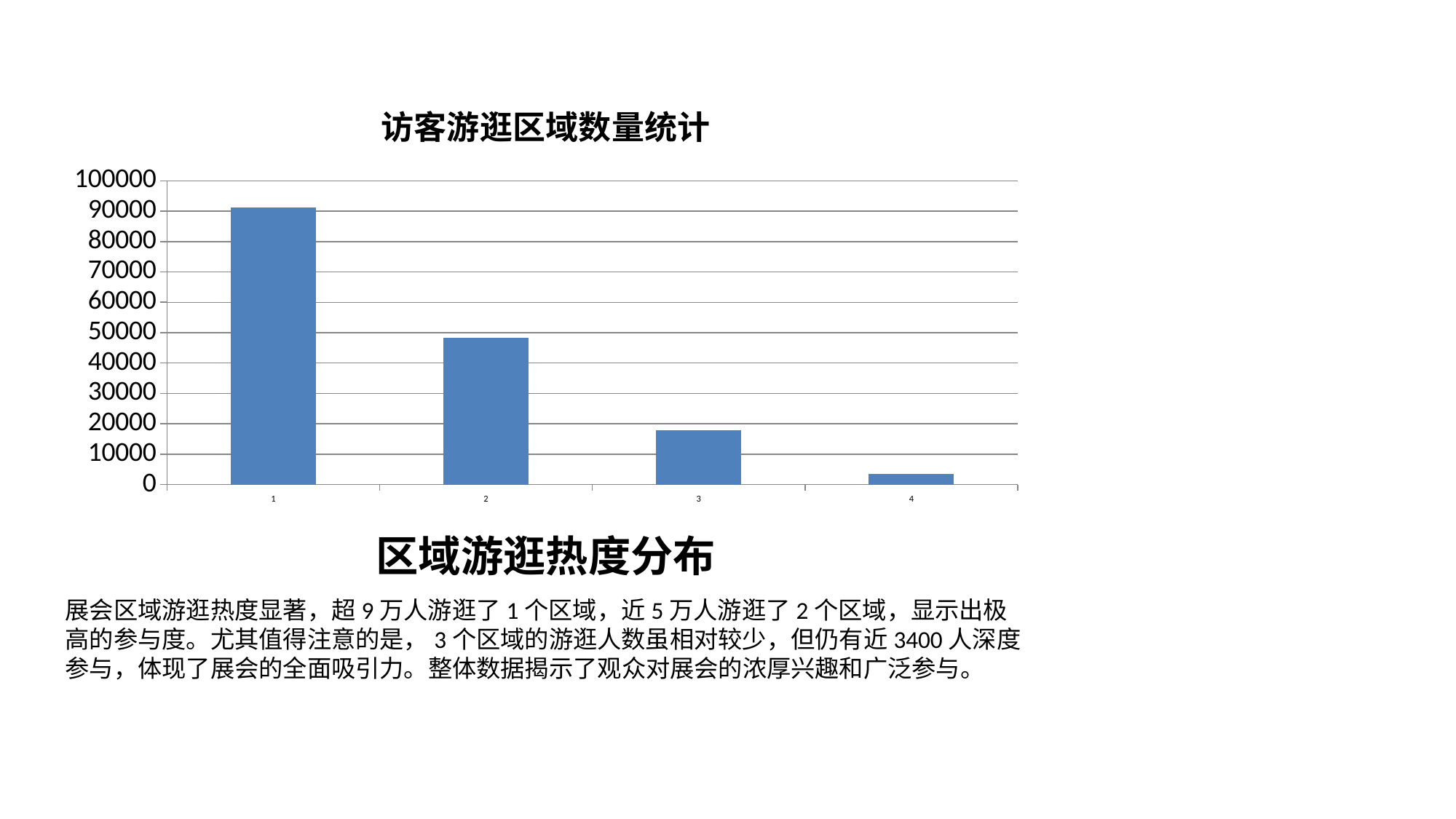
What is the title of the chart? 访客游逛区域数量统计 Is the value for category 4 greater or less than 10000? less What kind of chart is shown on the slide? bar chart Which category has the highest bar in the chart? 1 Is the value for category 3 greater or less than 20000? less Which is larger, the value for category 2 or the value for category 3? category 2 Do the bar values rise or fall from category 1 to category 4? fall Is the value for category 1 greater or less than 90000? greater What is the highest value shown on the vertical axis of the chart? 100000 How many categories are plotted on the x axis of the chart? 4 Which category has the lowest bar in the chart? 4